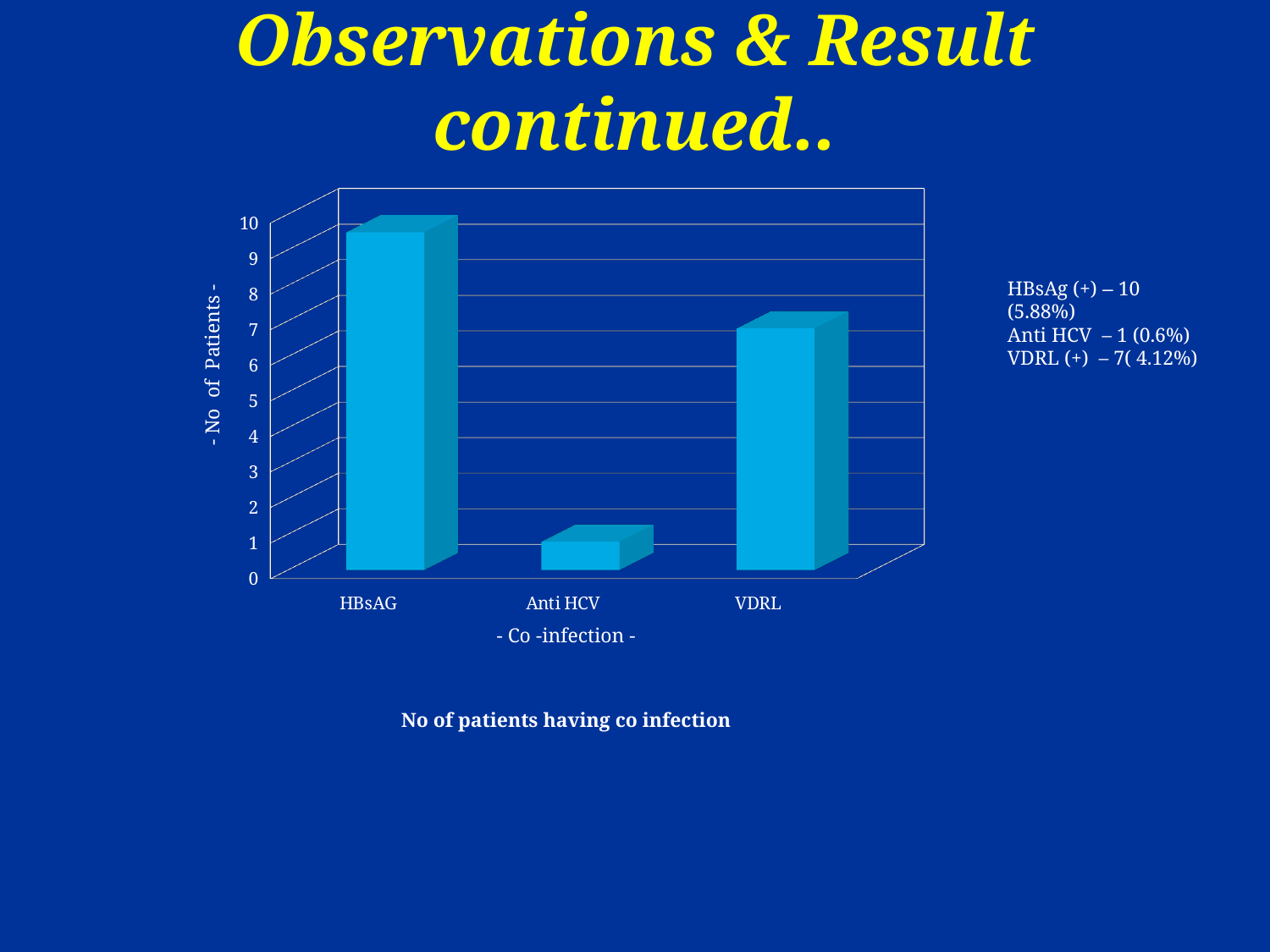
Which has more patients, VDRL or Anti HCV? VDRL Which co-infection category has the lowest number of patients? Anti HCV What is the difference in number of patients between HBsAG and VDRL? 3 What is the number of patients for HBsAG? 10 What is the number of patients for Anti HCV? 1 How many categories are shown on the x axis of the chart? 3 What kind of chart is shown on the slide? bar chart What is the number of patients for VDRL? 7 Which co-infection category has the highest number of patients? HBsAG What is the label of the y axis of the chart? - No of Patients - Is the value for VDRL greater or less than 5? greater What is the label of the x axis of the chart? - Co -infection -